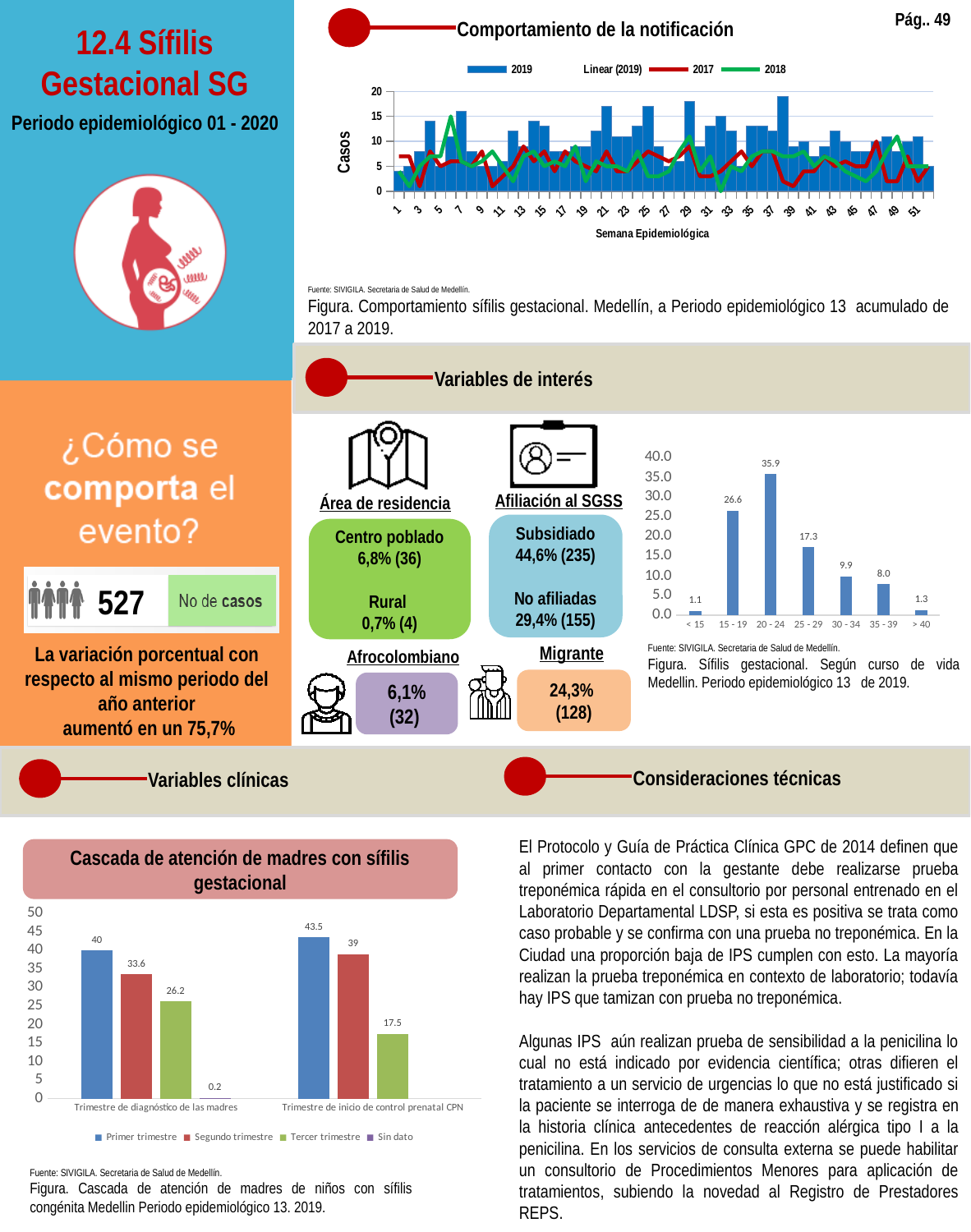
In the chart titled 'Cascada de atención de madres con sífilis gestacional', what is the value for Segundo trimestre in 'Trimestre de inicio de control prenatal CPN'? 39 In the chart titled 'Sífilis gestacional. Según curso de vida', what is the difference between the values for 15 - 19 and 25 - 29? 9.3 In the chart titled 'Cascada de atención de madres con sífilis gestacional', what is the difference between Tercer trimestre in 'Trimestre de diagnóstico de las madres' and Tercer trimestre in 'Trimestre de inicio de control prenatal CPN'? 8.7 In the chart titled 'Sífilis gestacional. Según curso de vida', which age group has the highest value? 20 - 24 In the chart titled 'Sífilis gestacional. Según curso de vida', what is the value for the 20 - 24 age group? 35.9 In the chart titled 'Cascada de atención de madres con sífilis gestacional', how many series does the legend list? 4 In the chart titled 'Sífilis gestacional. Según curso de vida', which age group has the lowest value? < 15 In the chart titled 'Comportamiento de la notificación', how many series does the legend list? 4 In the chart titled 'Cascada de atención de madres con sífilis gestacional', which is larger: Primer trimestre for 'Trimestre de diagnóstico de las madres' or Primer trimestre for 'Trimestre de inicio de control prenatal CPN'? Trimestre de inicio de control prenatal CPN In the chart titled 'Cascada de atención de madres con sífilis gestacional', what is the value for Sin dato in 'Trimestre de diagnóstico de las madres'? 0.2 In the chart titled 'Sífilis gestacional. Según curso de vida', how many age groups are shown? 7